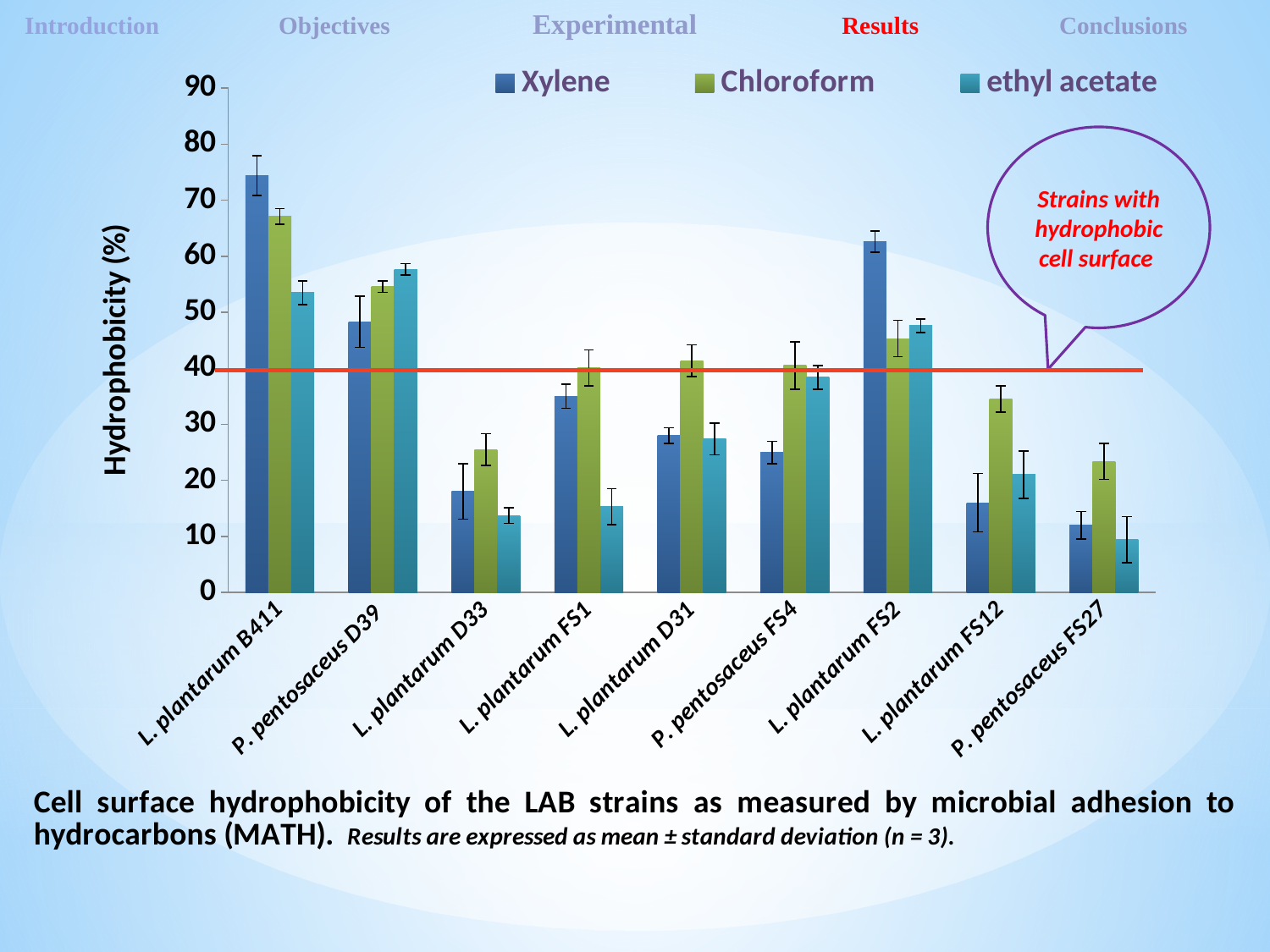
For L. plantarum FS2, which is larger: the Xylene value or the Chloroform value? Xylene Which strain has the lowest Xylene hydrophobicity? P. pentosaceus FS27 Is the ethyl acetate value for P. pentosaceus FS27 greater or less than 20? less What kind of chart is shown on the slide? Bar chart How many LAB strains are shown along the x axis? 9 What is the label of the y axis? Hydrophobicity (%) Which strain has the highest Chloroform hydrophobicity? L. plantarum B411 How many series does the legend list? 3 For L. plantarum FS1, which is larger: the Chloroform value or the ethyl acetate value? Chloroform Is the Xylene value for L. plantarum B411 greater or less than 70? greater Is the Xylene value for L. plantarum FS12 greater or less than 20? less Which strain has the highest Xylene hydrophobicity? L. plantarum B411